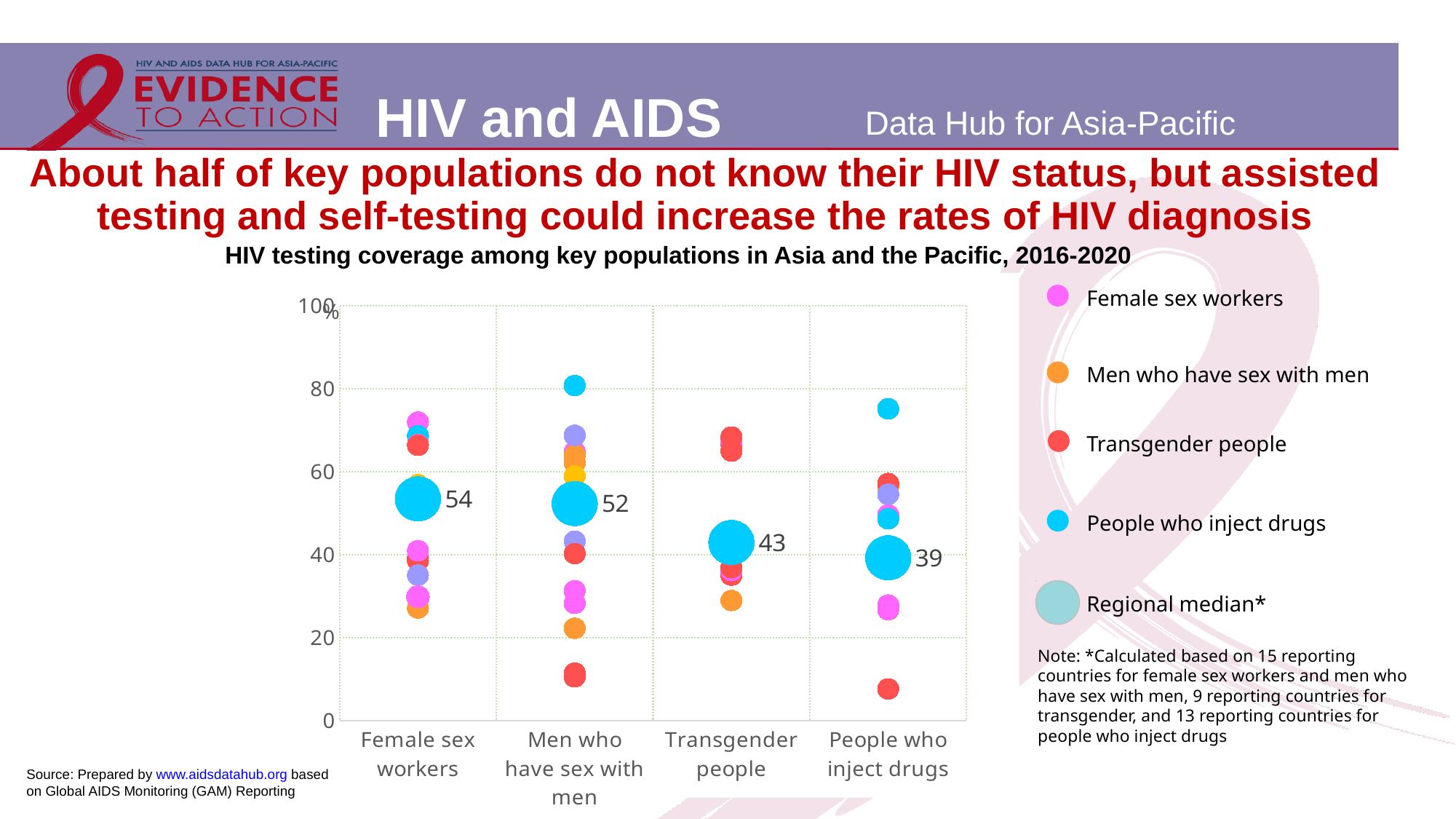
How many key population categories are shown on the x axis? 4 Which key population has the highest regional median HIV testing coverage? Female sex workers What is the regional median HIV testing coverage for people who inject drugs? 39 What is the regional median HIV testing coverage for transgender people? 43 Do the regional medians rise or fall moving from left to right across the categories? Fall What is the difference between the regional median for female sex workers and the regional median for people who inject drugs? 15 Which is larger: the regional median for men who have sex with men or for transgender people? Men who have sex with men What type of chart is shown on the slide? Scatter chart What is the regional median HIV testing coverage for men who have sex with men? 52 Which key population has the lowest regional median HIV testing coverage? People who inject drugs What is the regional median HIV testing coverage for female sex workers? 54 Is the lowest data point for people who inject drugs greater or less than 20? less